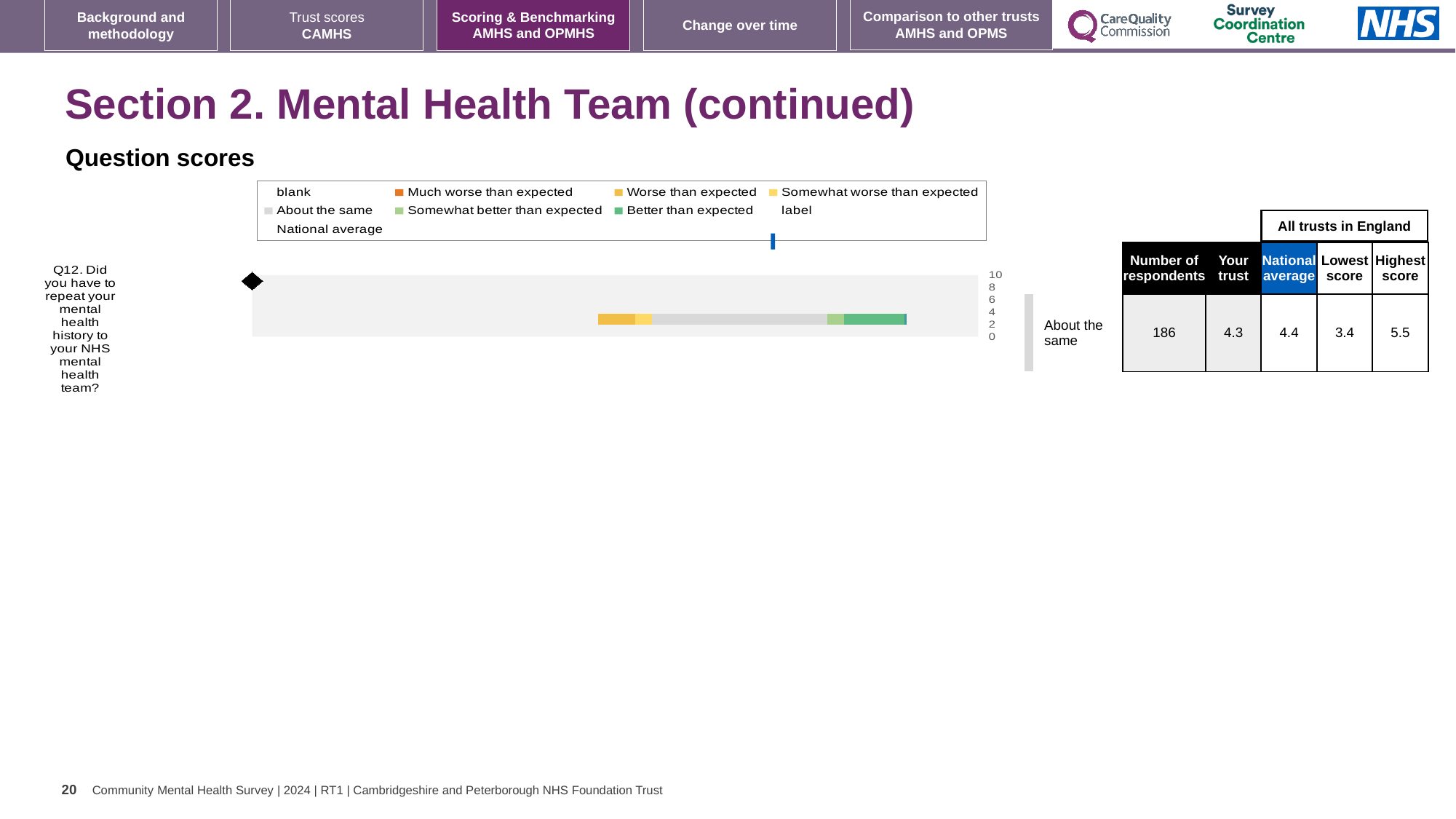
What is the lowest score among all trusts in England for Q12? 3.4 How many questions are plotted on the chart? 1 Which is larger for Q12: the trust's score or the national average? national average What is the national average score for Q12? 4.4 Which benchmark category is the trust's Q12 score placed in, according to the label next to the chart? About the same What is the highest score among all trusts in England for Q12? 5.5 What kind of chart is used to show the Q12 question score? bar chart What is the 'Your trust' score for Q12? 4.3 What is the difference between the national average and the trust's score for Q12? 0.1 How many respondents answered Q12? 186 What is the difference between the highest and lowest scores for Q12 across all trusts in England? 2.1 Which legend entry is shown with a dark green colour? Better than expected